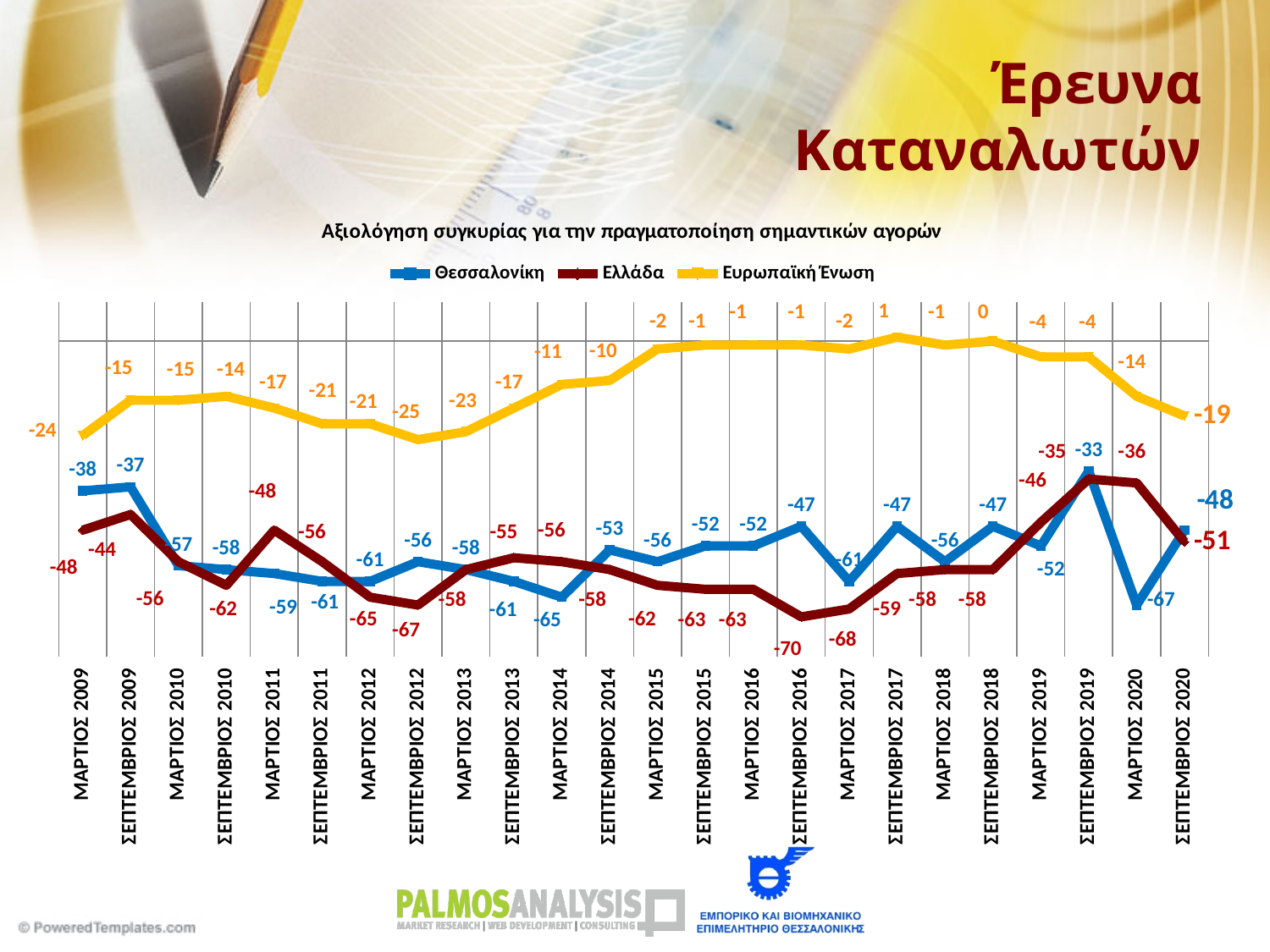
In which period does the Ελλάδα series reach its lowest value? ΣΕΠΤΕΜΒΡΙΟΣ 2016 What colour is used for the Ελλάδα series? Dark red What is the value for Ελλάδα in ΣΕΠΤΕΜΒΡΙΟΣ 2016? -70 How many series does the legend list? 3 What is the value for Θεσσαλονίκη in ΜΑΡΤΙΟΣ 2020? -67 In which period does the Ευρωπαϊκή Ένωση series reach its highest value? ΣΕΠΤΕΜΒΡΙΟΣ 2017 What kind of chart is shown on the slide? Line chart By how much did the Θεσσαλονίκη value change between ΣΕΠΤΕΜΒΡΙΟΣ 2019 and ΜΑΡΤΙΟΣ 2020? 34 In which period does the Θεσσαλονίκη series reach its highest value? ΣΕΠΤΕΜΒΡΙΟΣ 2019 What is the value for Ευρωπαϊκή Ένωση in ΣΕΠΤΕΜΒΡΙΟΣ 2020? -19 How many time points are plotted along the x axis? 24 In ΜΑΡΤΙΟΣ 2009, which is higher: the value for Θεσσαλονίκη or for Ελλάδα? Θεσσαλονίκη